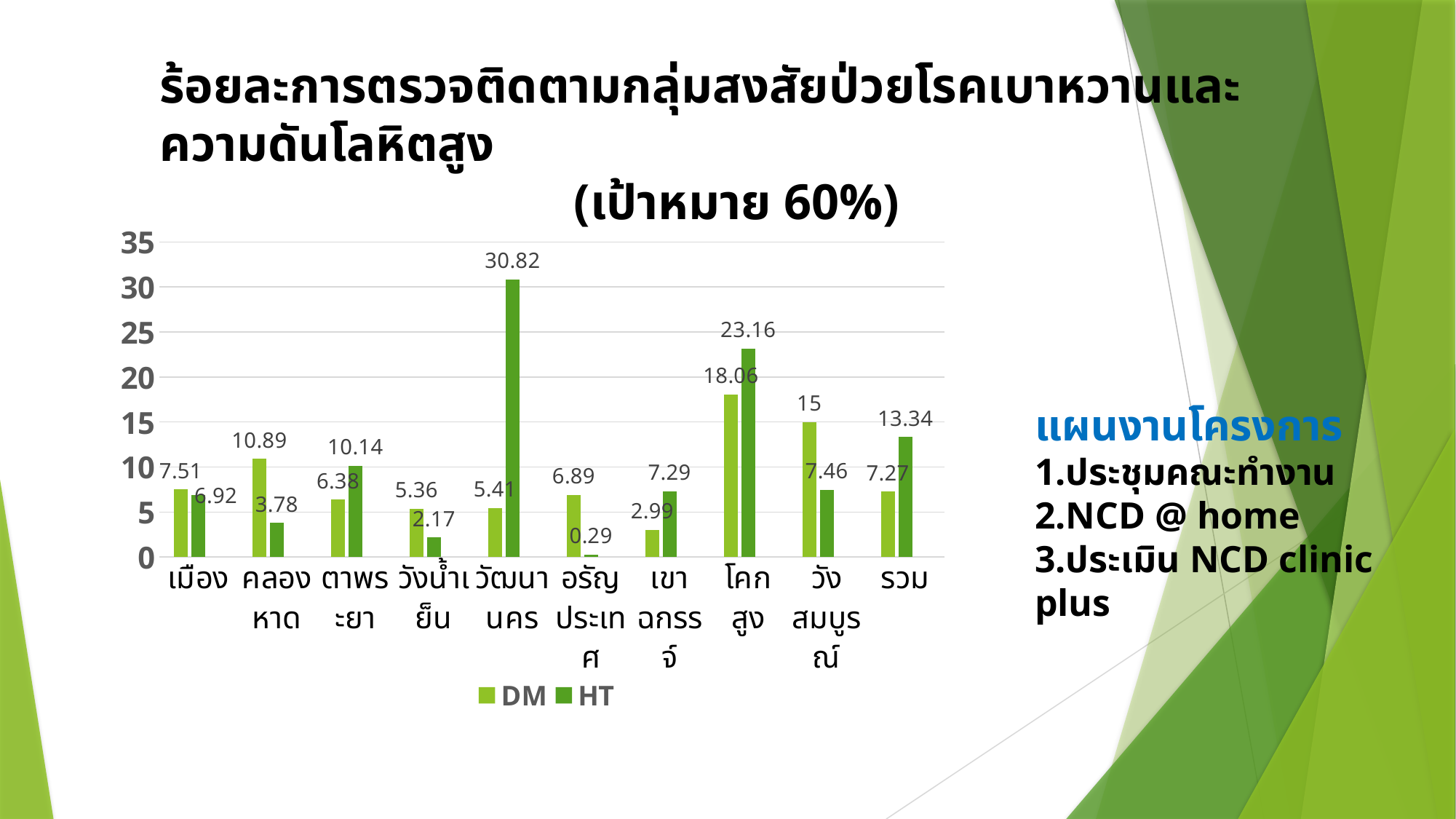
How many categories are shown on the x axis? 10 How many series does the legend list? 2 What is the difference between the HT and DM values for โคกสูง? 5.1 Which category has the lowest HT value? อรัญประเทศ What is the DM value for วังสมบูรณ์? 15 What is the HT value for วัฒนานคร? 30.82 What is the DM value for เมือง? 7.51 Which category has the highest DM value? โคกสูง What kind of chart is shown on the slide? Bar chart For คลองหาด, which is larger, the DM value or the HT value? DM Which category has the highest HT value? วัฒนานคร What is the HT value for รวม? 13.34